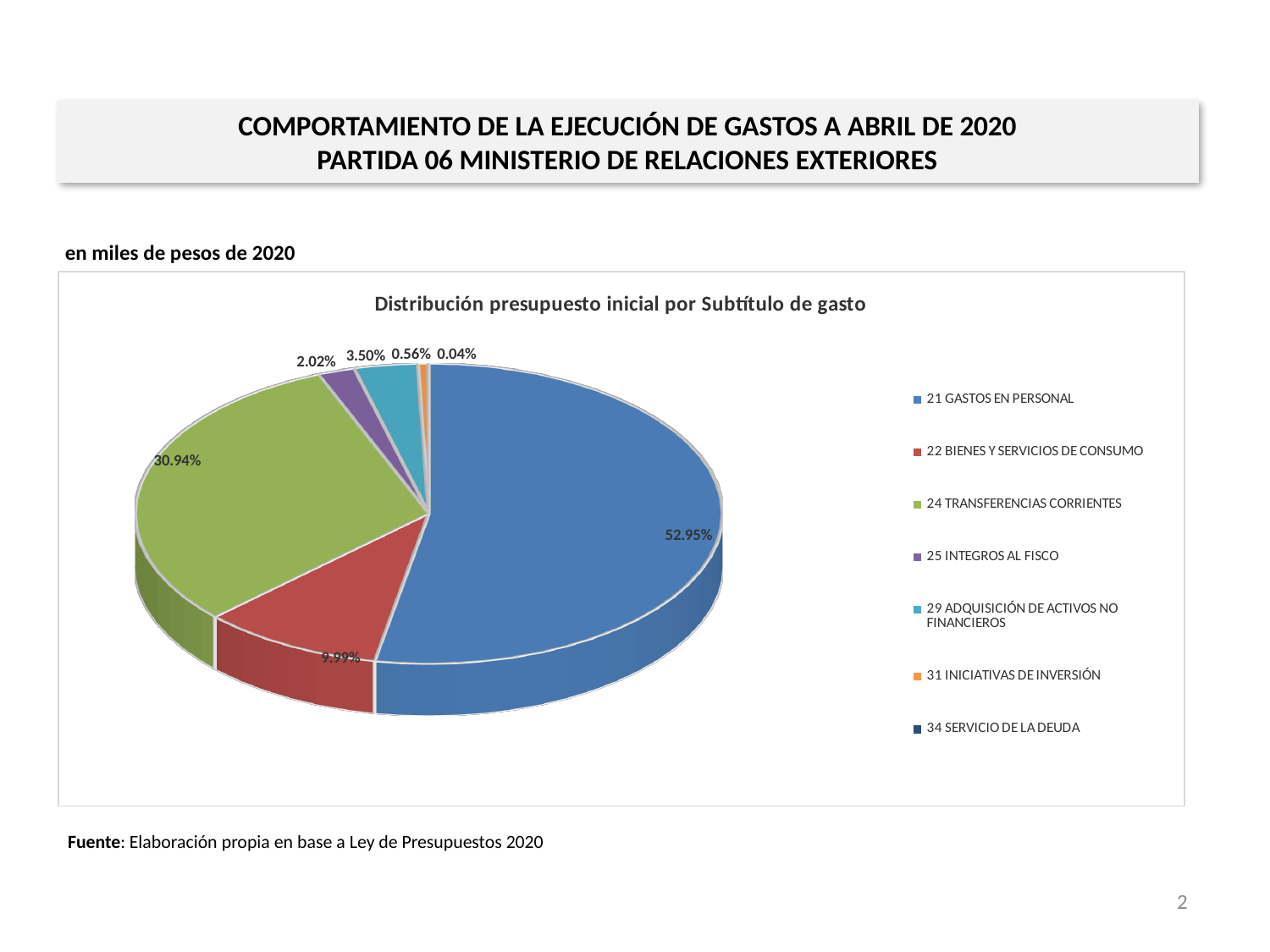
Which category has the smallest share of the pie? 34 SERVICIO DE LA DEUDA What share of the pie does 21 GASTOS EN PERSONAL represent? 52.95% What is the title of the chart? Distribución presupuesto inicial por Subtítulo de gasto Which is larger, the share for 25 INTEGROS AL FISCO or the share for 29 ADQUISICIÓN DE ACTIVOS NO FINANCIEROS? 29 ADQUISICIÓN DE ACTIVOS NO FINANCIEROS What is the value shown for 22 BIENES Y SERVICIOS DE CONSUMO? 9.99% What colour is the slice for 31 INICIATIVAS DE INVERSIÓN? Orange What is the difference in percentage points between 21 GASTOS EN PERSONAL and 24 TRANSFERENCIAS CORRIENTES? 22.01 What type of chart is shown on the slide? Pie chart What is the value shown for 29 ADQUISICIÓN DE ACTIVOS NO FINANCIEROS? 3.50% What share of the pie does 24 TRANSFERENCIAS CORRIENTES represent? 30.94% Which category has the largest share of the pie? 21 GASTOS EN PERSONAL How many categories does the legend of the pie chart list? 7